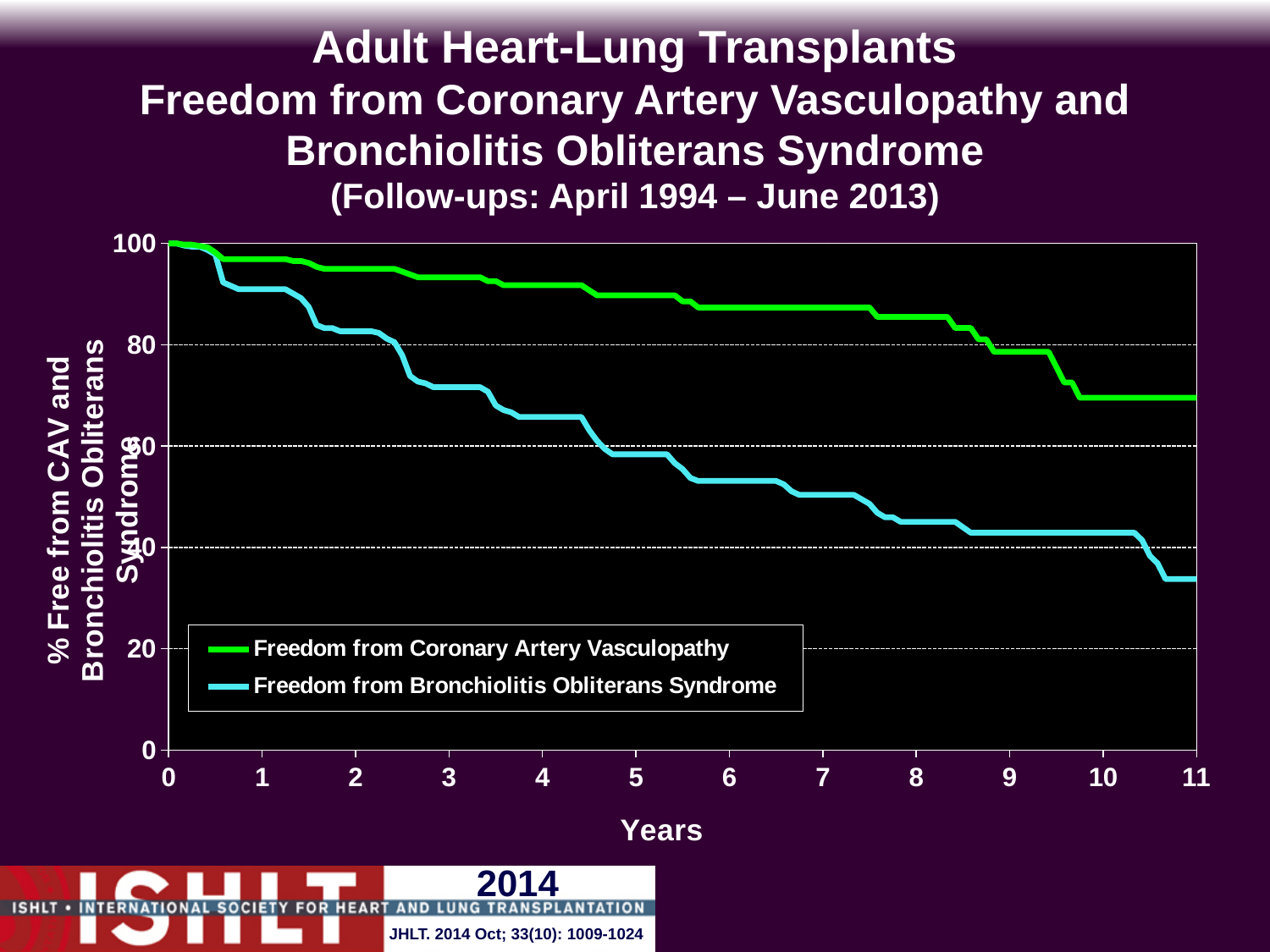
How many series does the legend list? 2 At year 5, which series has the higher value: Freedom from Coronary Artery Vasculopathy or Freedom from Bronchiolitis Obliterans Syndrome? Freedom from Coronary Artery Vasculopathy Is the value for Freedom from Coronary Artery Vasculopathy at year 5 greater or less than 80? greater What is the label of the x axis? Years Do the values for Freedom from Bronchiolitis Obliterans Syndrome rise or fall as years increase? fall Do the values for Freedom from Coronary Artery Vasculopathy rise or fall as years increase? fall Is the value for Freedom from Coronary Artery Vasculopathy at year 10 greater or less than 80? less Is the value for Freedom from Bronchiolitis Obliterans Syndrome at year 3 greater or less than 80? less What kind of chart is shown on the slide? line chart What colour is the line for Freedom from Bronchiolitis Obliterans Syndrome? light blue